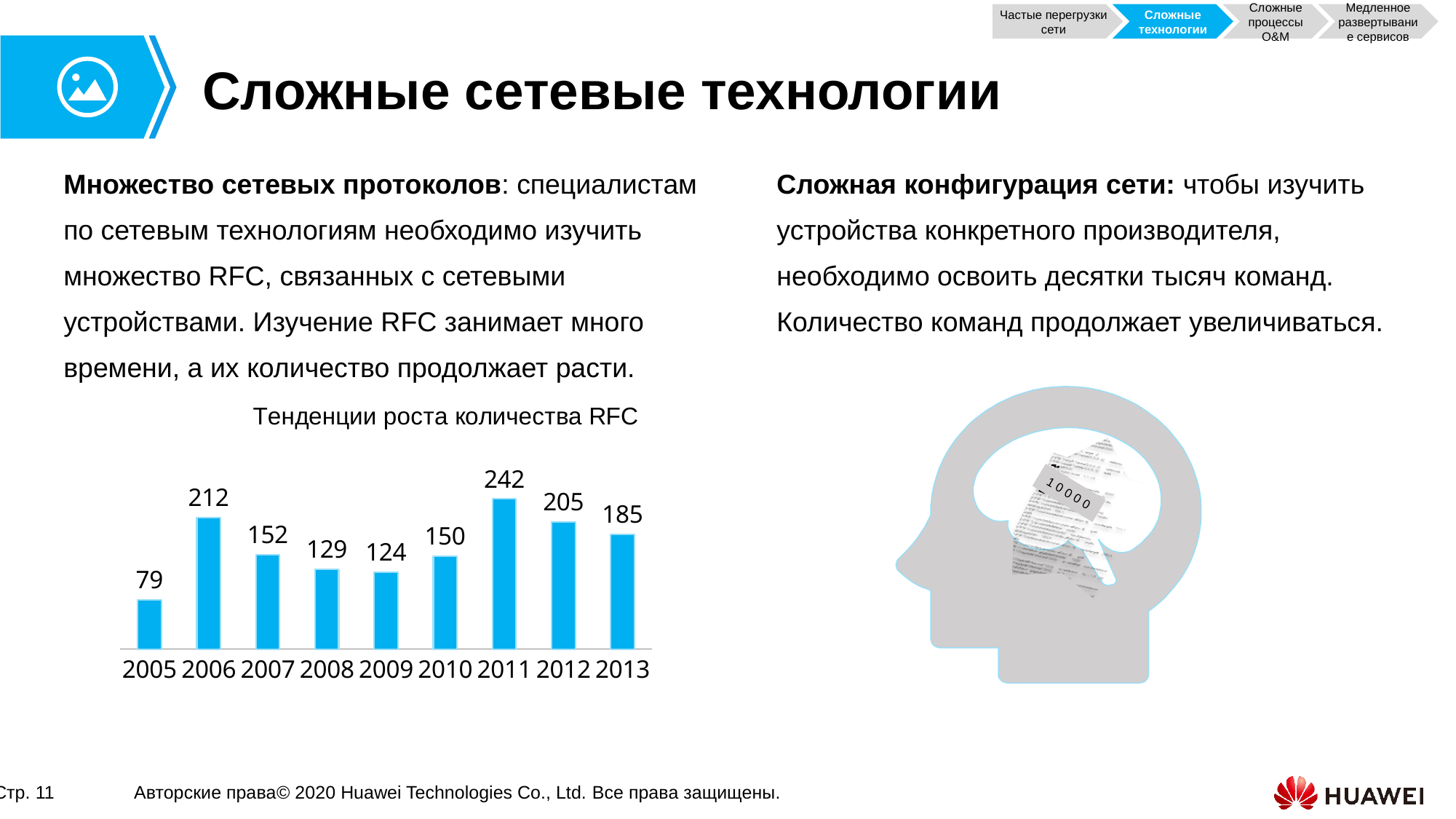
Does the value in the RFC growth chart rise or fall from 2011 to 2013? fall What is the title of the chart on the slide? Тенденции роста количества RFC Which year has the lowest value in the RFC growth chart? 2005 What is the value for 2005 in the RFC growth chart? 79 How many years are shown in the RFC growth chart? 9 What kind of chart is used to show the RFC growth trend? bar chart Which year has the highest value in the RFC growth chart? 2011 What is the value for 2011 in the RFC growth chart? 242 Which is larger in the RFC growth chart, the value for 2007 or the value for 2010? 2007 What is the difference between the values for 2011 and 2012 in the RFC growth chart? 37 What is the difference between the values for 2006 and 2005 in the RFC growth chart? 133 What is the value for 2009 in the RFC growth chart? 124